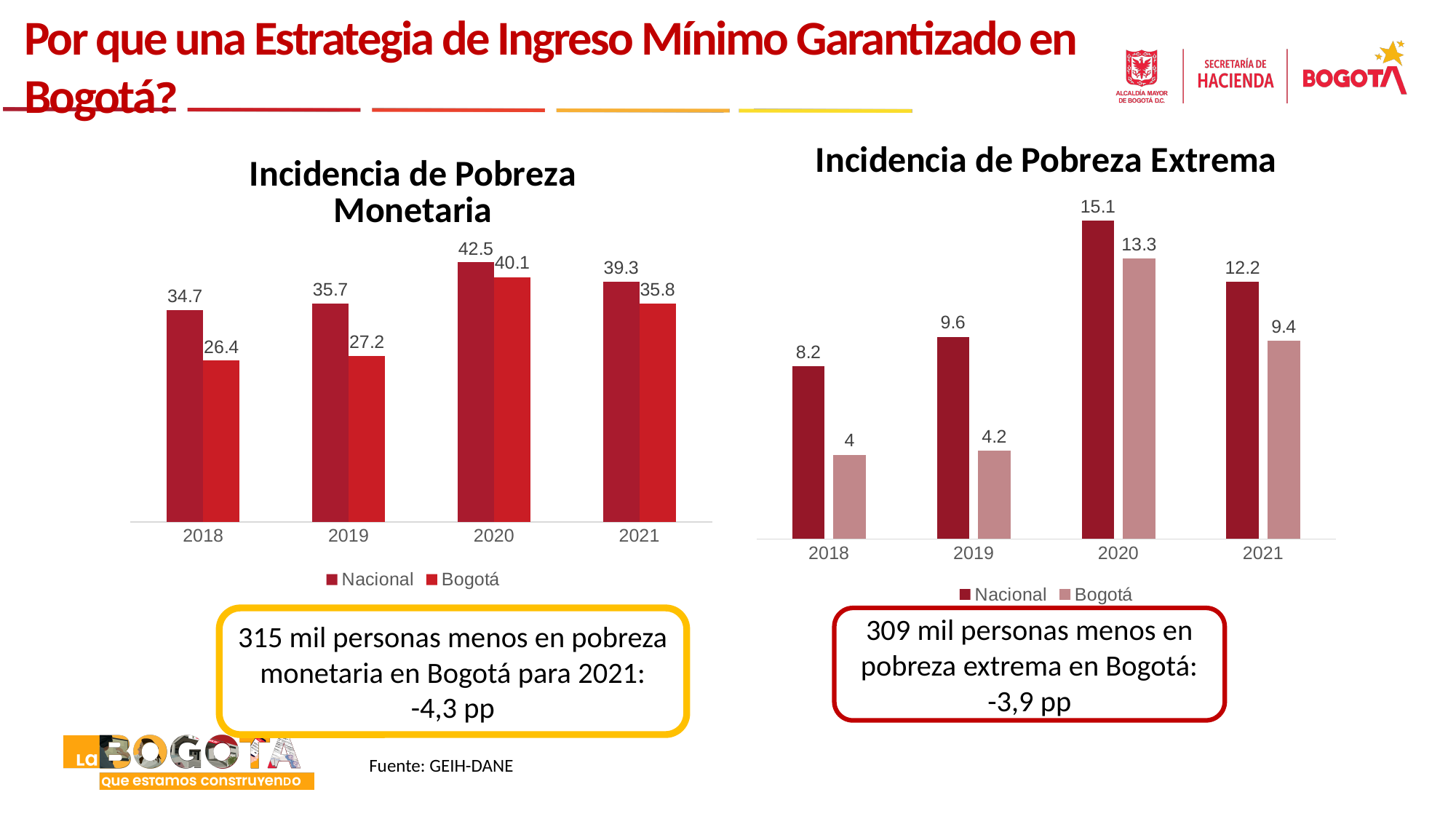
In the 'Incidencia de Pobreza Monetaria' chart, what is the Nacional value for 2020? 42.5 In the 'Incidencia de Pobreza Monetaria' chart, which year has the highest Bogotá value? 2020 How many years are shown on the x axis of the 'Incidencia de Pobreza Monetaria' chart? 4 In the 'Incidencia de Pobreza Extrema' chart, which year has the lowest Bogotá value? 2018 In the 'Incidencia de Pobreza Monetaria' chart, what is the Bogotá value for 2018? 26.4 In the 'Incidencia de Pobreza Extrema' chart, what is the difference between the Bogotá values for 2020 and 2021? 3.9 How many series does the legend of the 'Incidencia de Pobreza Extrema' chart list? 2 What kind of chart is the 'Incidencia de Pobreza Monetaria' chart? Bar chart In the 'Incidencia de Pobreza Extrema' chart, what is the Bogotá value for 2021? 9.4 In the 'Incidencia de Pobreza Monetaria' chart, what is the difference between the Nacional and Bogotá values for 2021? 3.5 In the 'Incidencia de Pobreza Extrema' chart, what is the Nacional value for 2018? 8.2 In the 'Incidencia de Pobreza Extrema' chart, which is larger in 2019: the Nacional value or the Bogotá value? Nacional